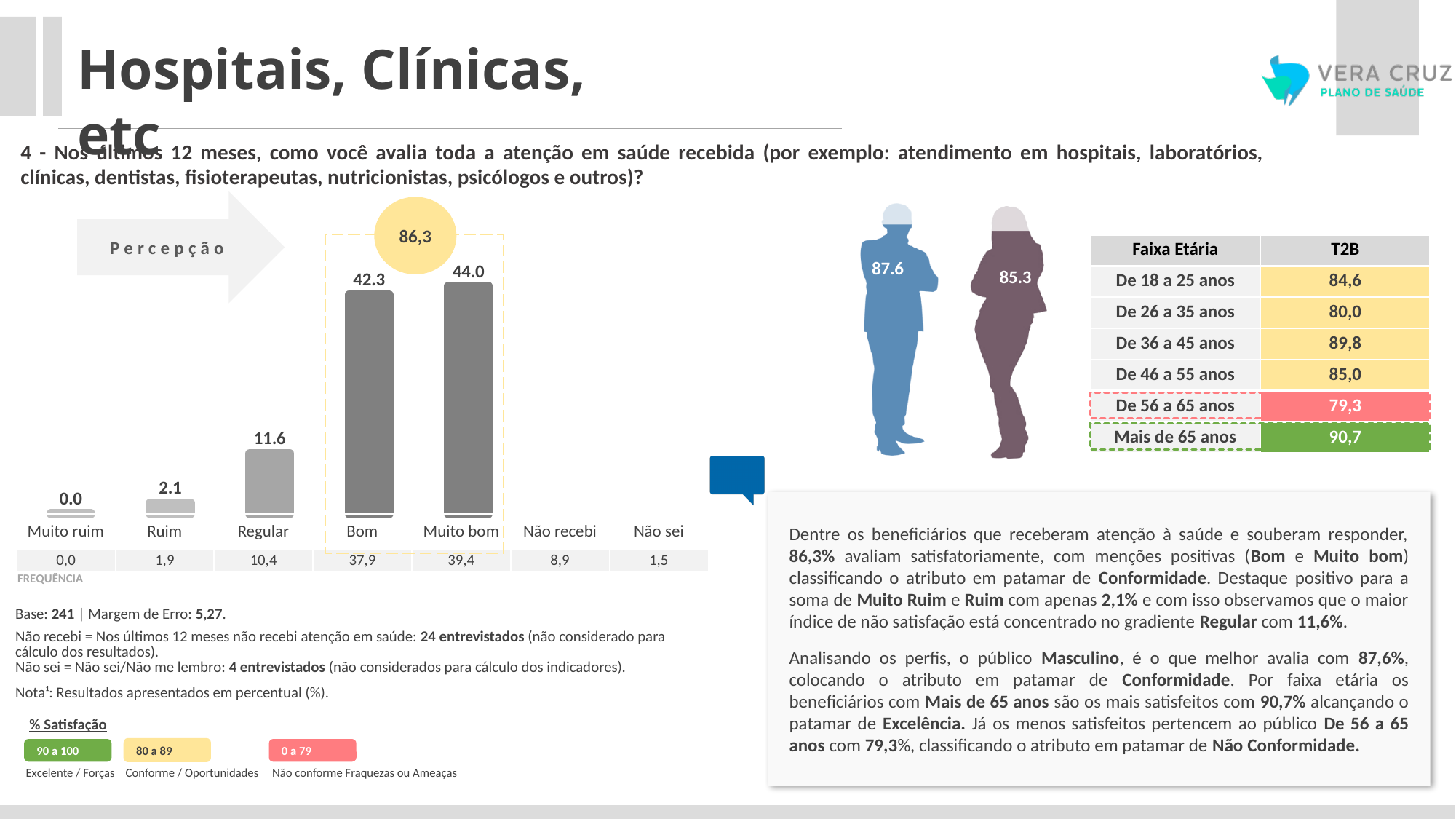
Do the bar values rise or fall going from Muito ruim to Muito bom along the x axis? rise What is the value for Muito ruim in the bar chart? 0.0 Which category has the lowest value in the bar chart? Muito ruim Which category has the highest bar in the chart? Muito bom What is the difference between the values for Muito bom and Bom? 1.7 What is the value for Bom in the bar chart? 42.3 What is the value for Ruim in the bar chart? 2.1 What is the value for Regular in the bar chart? 11.6 What is the value for Muito bom in the bar chart? 44.0 Which is larger, the value for Regular or the value for Ruim? Regular What value is shown in the yellow circle above the Bom and Muito bom bars? 86,3 What kind of chart is shown on the slide? bar chart